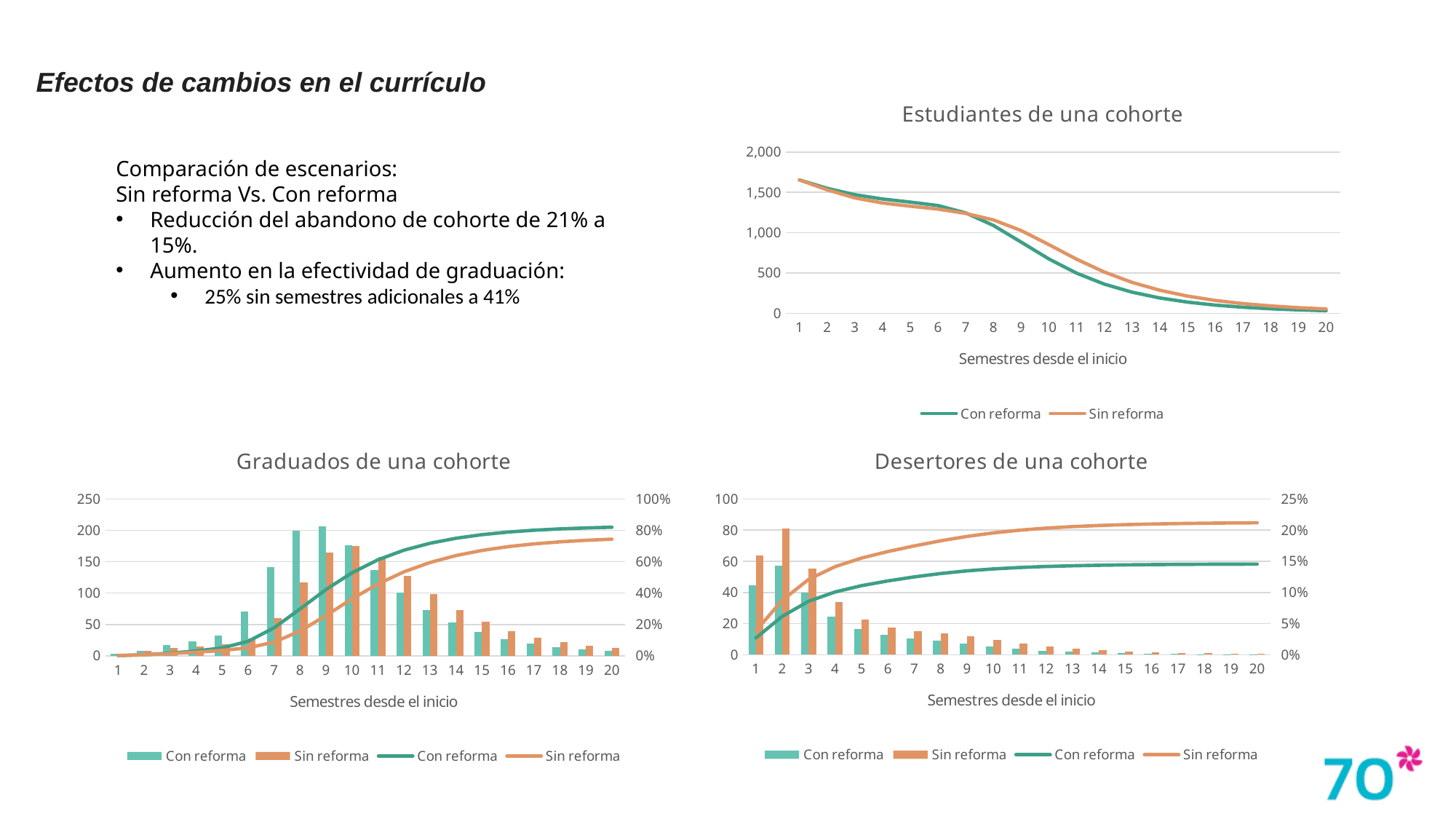
In the 'Graduados de una cohorte' chart, is the 'Con reforma' bar at semester 7 greater or less than 100? greater How many semesters are shown on the x axis of the 'Estudiantes de una cohorte' chart? 20 In the 'Estudiantes de una cohorte' chart, is the 'Con reforma' value at semester 1 greater or less than 1,500? greater In the 'Estudiantes de una cohorte' chart, is the 'Con reforma' value at semester 13 greater or less than 500? less In the 'Estudiantes de una cohorte' chart, which series is higher at semester 10? Sin reforma In the 'Estudiantes de una cohorte' chart, do the values rise or fall as the semesters increase? Fall How many entries does the legend of the 'Graduados de una cohorte' chart list? 4 What kind of chart is the 'Estudiantes de una cohorte' chart? Line chart What is the x-axis title of the 'Desertores de una cohorte' chart? Semestres desde el inicio How many series does the legend of the 'Estudiantes de una cohorte' chart list? 2 In the 'Graduados de una cohorte' chart, which cumulative line is higher at semester 20? Con reforma In the 'Desertores de una cohorte' chart, at which semester is the 'Sin reforma' bar highest? 2